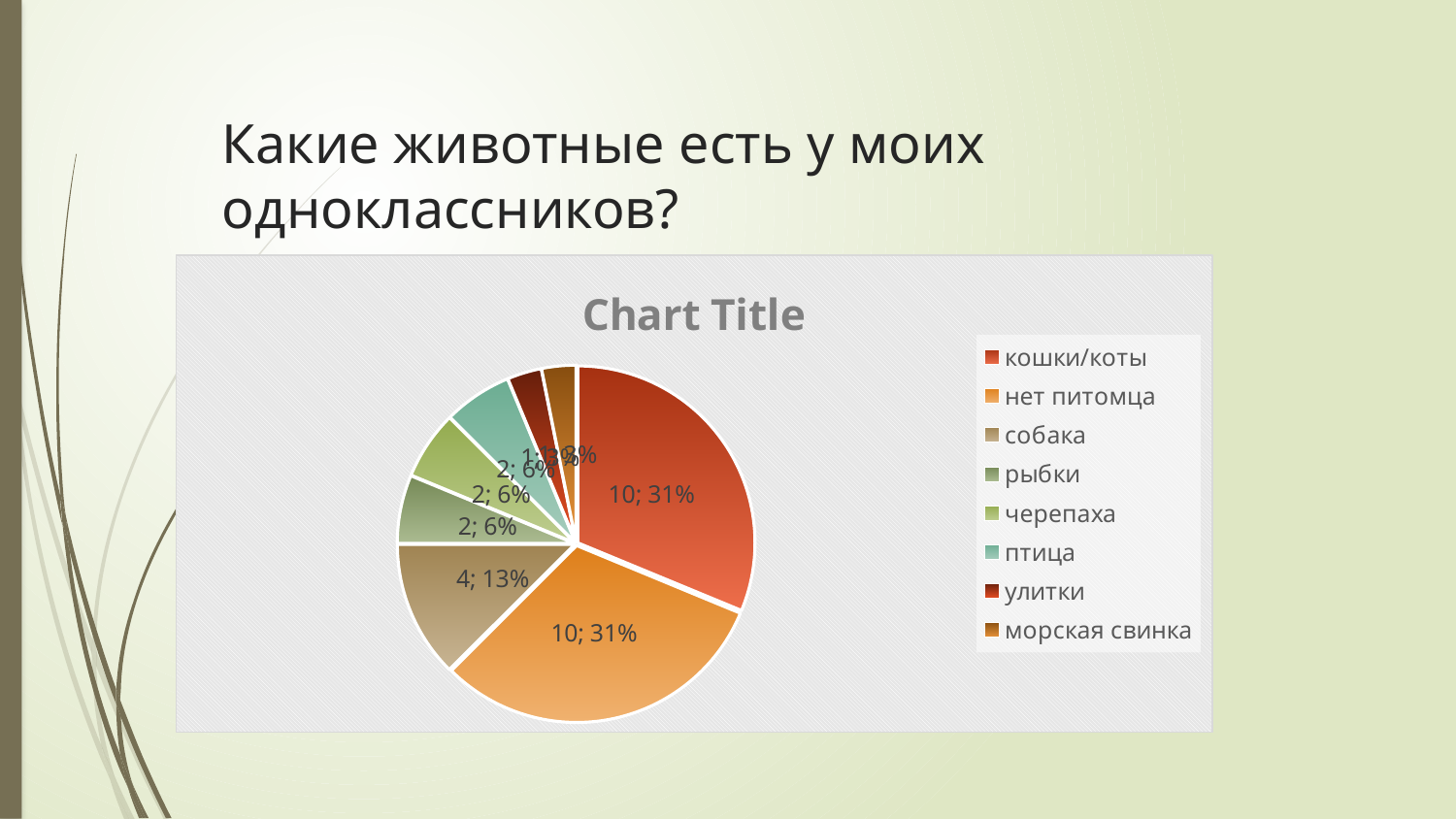
What share of the pie does the кошки/коты slice represent? 31% Which category is listed first in the legend of the pie chart? кошки/коты What share of the pie does the черепаха slice represent? 6% Which is larger, the собака slice or the птица slice? собака How many categories does the legend of the pie chart list? 8 What is the data label shown for the собака slice? 4; 13% What share of the pie does the нет питомца slice represent? 31% What kind of chart is shown on the slide? pie chart What is the count shown for the рыбки slice? 2 What is the difference between the count for собака and the count for рыбки? 2 What is the title shown above the pie chart? Chart Title